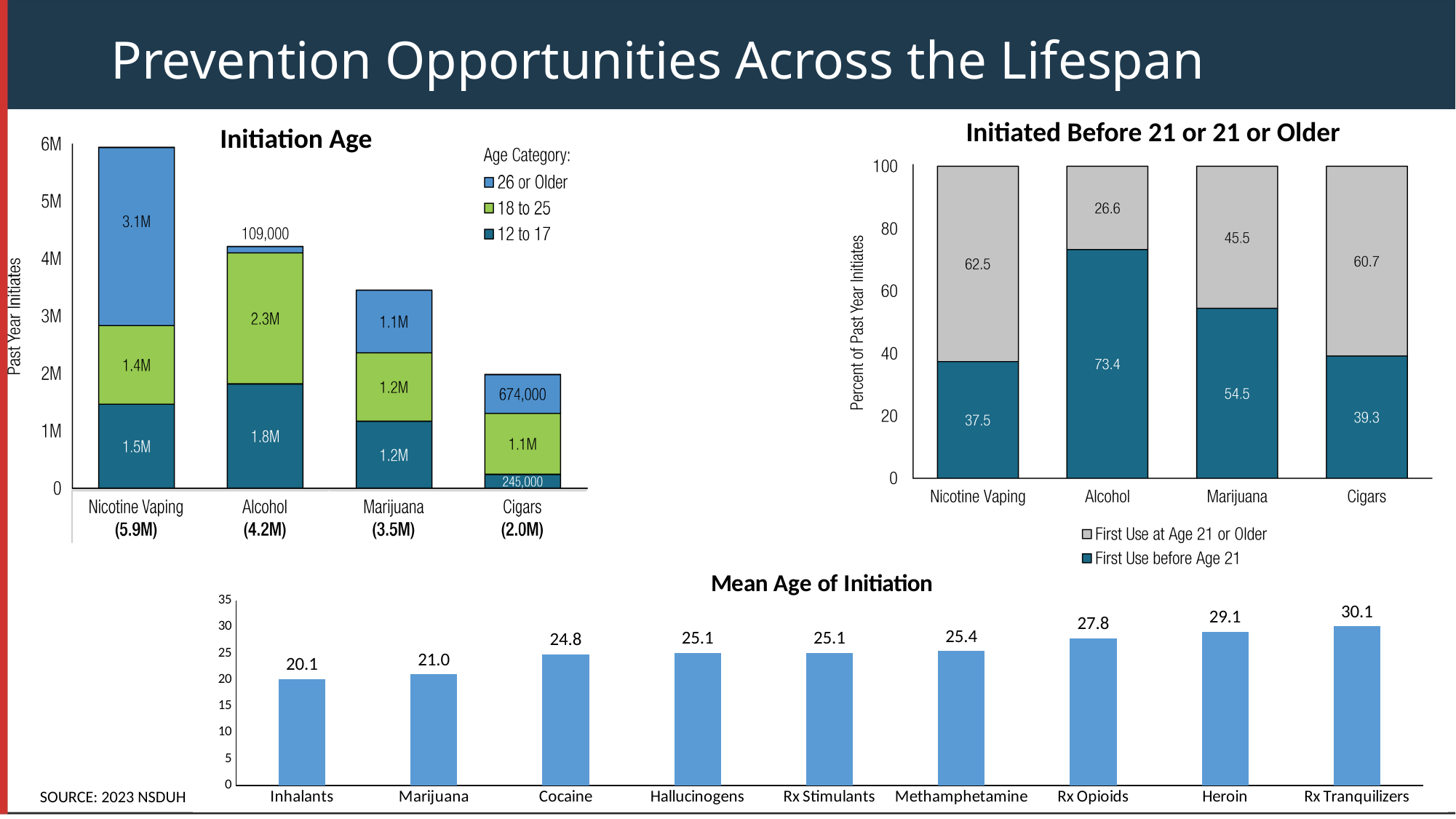
In the Initiated Before 21 or 21 or Older chart, which has a larger percent of first use before age 21, Marijuana or Nicotine Vaping? Marijuana What kind of chart is the Mean Age of Initiation chart? bar chart In the Initiation Age chart, what is the value for the 12 to 17 age category for Alcohol? 1.8M In the Mean Age of Initiation chart, what is the difference between the mean age for Heroin and for Inhalants? 9.0 In the Mean Age of Initiation chart, which substance has the lowest mean age of initiation? Inhalants In the Initiation Age chart, what is the total number of past year initiates for Nicotine Vaping? 5.9M In the Initiation Age chart, how many age categories does the legend list? 3 In the Initiated Before 21 or 21 or Older chart, which substance has the highest percent of first use at age 21 or older? Nicotine Vaping In the Mean Age of Initiation chart, which substance has the highest mean age of initiation? Rx Tranquilizers In the Initiated Before 21 or 21 or Older chart, what percent of Alcohol initiates had first use before age 21? 73.4 In the Mean Age of Initiation chart, how many substances are shown? 9 In the Initiation Age chart, what is the value for the 26 or Older category for Cigars? 674,000